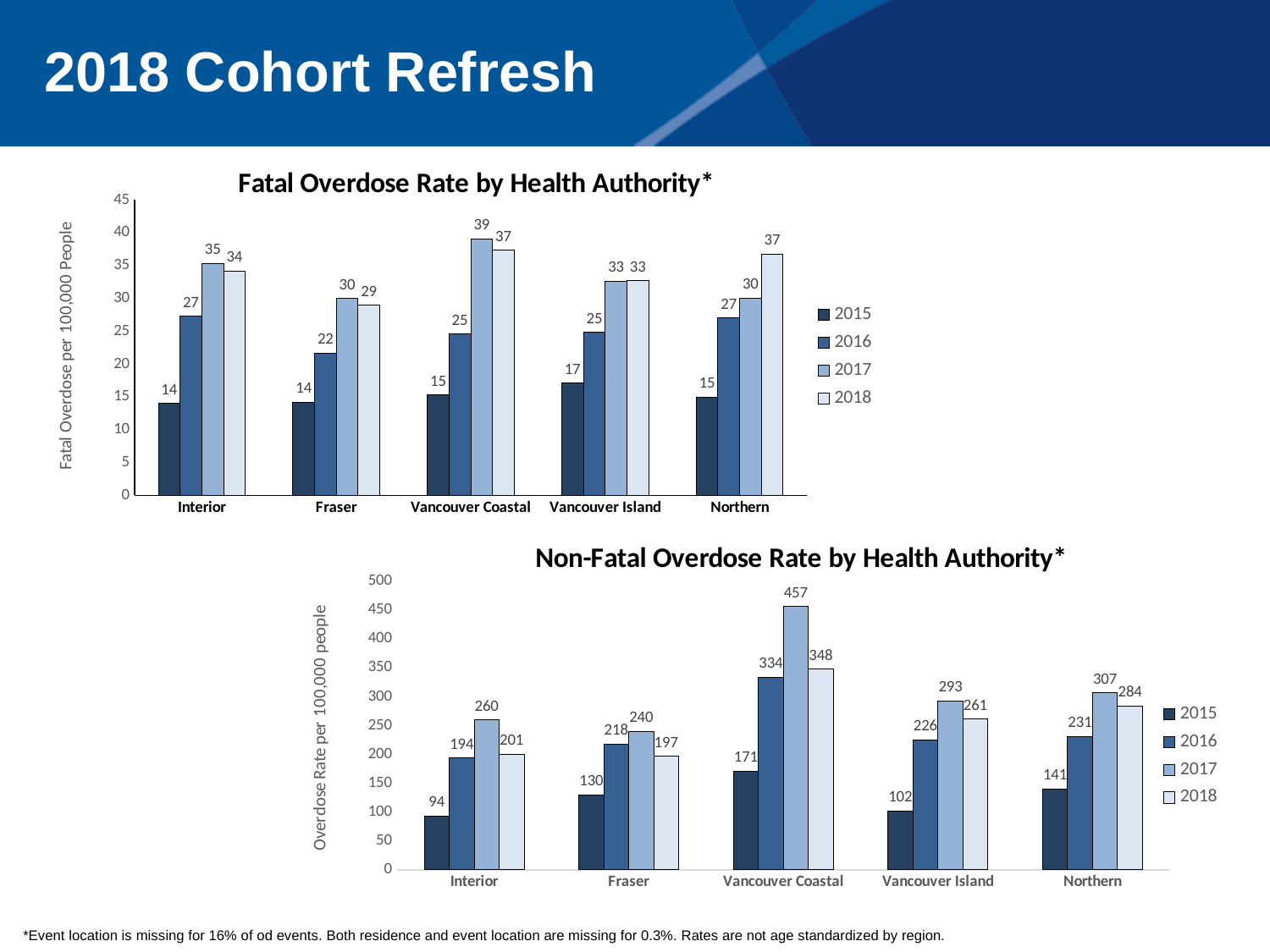
In the Non-Fatal Overdose Rate by Health Authority chart, what is the value for Vancouver Coastal in 2017? 457 In the Non-Fatal Overdose Rate by Health Authority chart, is the 2016 value for Northern larger or the 2016 value for Vancouver Island? Northern In the Fatal Overdose Rate by Health Authority chart, what is the value for Vancouver Coastal in 2017? 39 How many health authorities are shown on the x axis of the Non-Fatal Overdose Rate by Health Authority chart? 5 In the Non-Fatal Overdose Rate by Health Authority chart, which health authority has the lowest 2018 value? Fraser In the Fatal Overdose Rate by Health Authority chart, what is the value for Northern in 2018? 37 In the Fatal Overdose Rate by Health Authority chart, which health authority has the highest 2015 value? Vancouver Island In the Fatal Overdose Rate by Health Authority chart, what is the difference between the 2017 and 2015 values for Interior? 21 In the Fatal Overdose Rate by Health Authority chart, how many series does the legend list? 4 In the Non-Fatal Overdose Rate by Health Authority chart, what is the value for Interior in 2015? 94 In the Non-Fatal Overdose Rate by Health Authority chart, what is the difference between the 2017 and 2018 values for Vancouver Coastal? 109 What kind of chart is the Fatal Overdose Rate by Health Authority chart? Bar chart